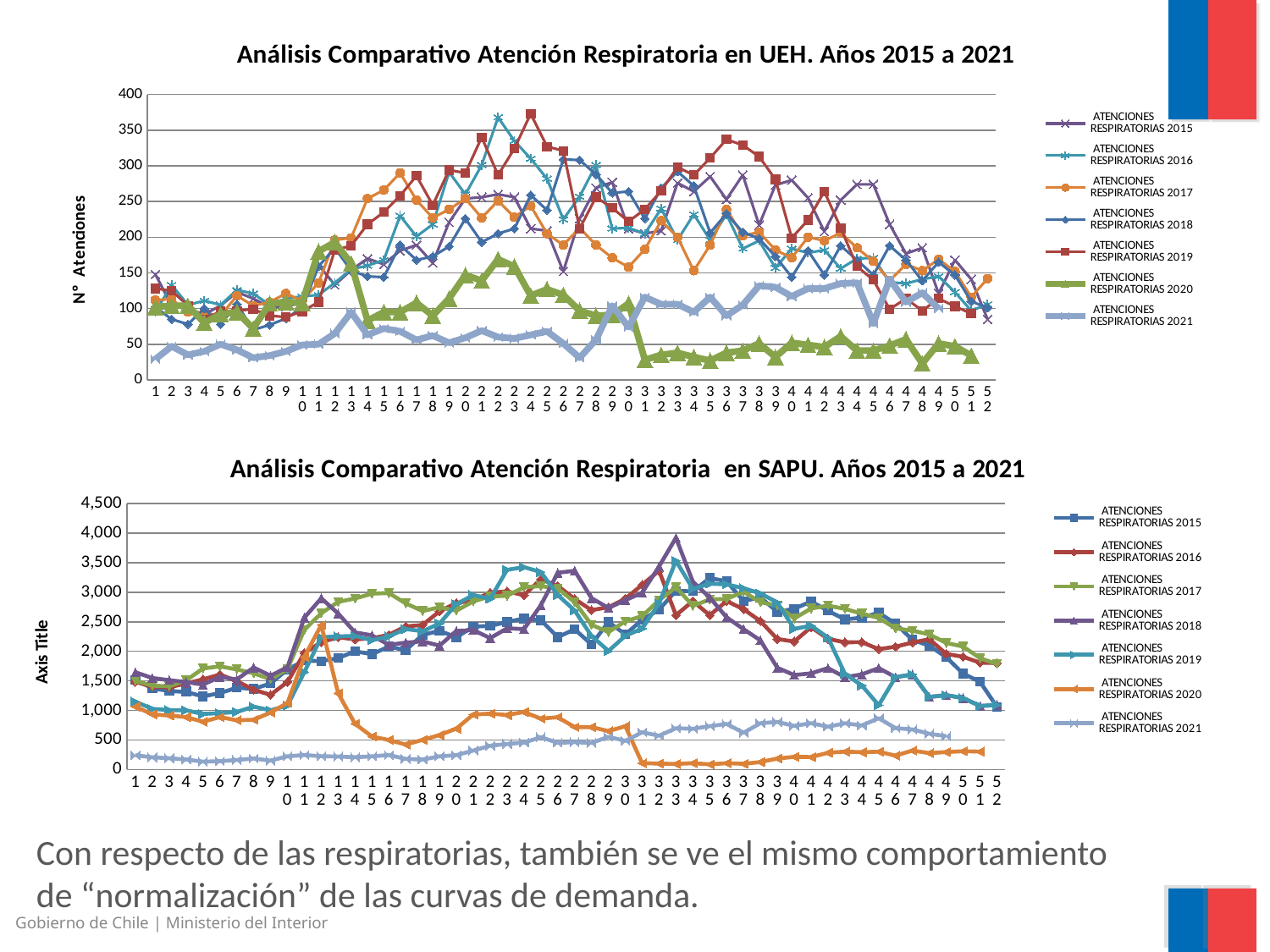
How many series does the legend of the top chart (UEH) list? 7 In the top chart (UEH), is the value for ATENCIONES RESPIRATORIAS 2016 at week 22 greater or less than 350? greater How many points (weeks) are plotted along the x axis of the bottom chart (SAPU)? 52 What is the y-axis title of the top chart (UEH)? N° Atenciones What kind of chart is the top chart, 'Análisis Comparativo Atención Respiratoria en UEH. Años 2015 a 2021'? Line chart In the bottom chart (SAPU), which series reaches the highest peak value? ATENCIONES RESPIRATORIAS 2018 In the top chart (UEH), is the value for ATENCIONES RESPIRATORIAS 2020 at week 40 greater or less than 100? less In the bottom chart (SAPU), is the value for ATENCIONES RESPIRATORIAS 2020 at week 40 greater or less than 500? less In the bottom chart (SAPU), at week 40, which series has the larger value: ATENCIONES RESPIRATORIAS 2020 or ATENCIONES RESPIRATORIAS 2021? ATENCIONES RESPIRATORIAS 2021 What is the y-axis title shown on the bottom chart (SAPU)? Axis Title How many series does the legend of the bottom chart (SAPU) list? 7